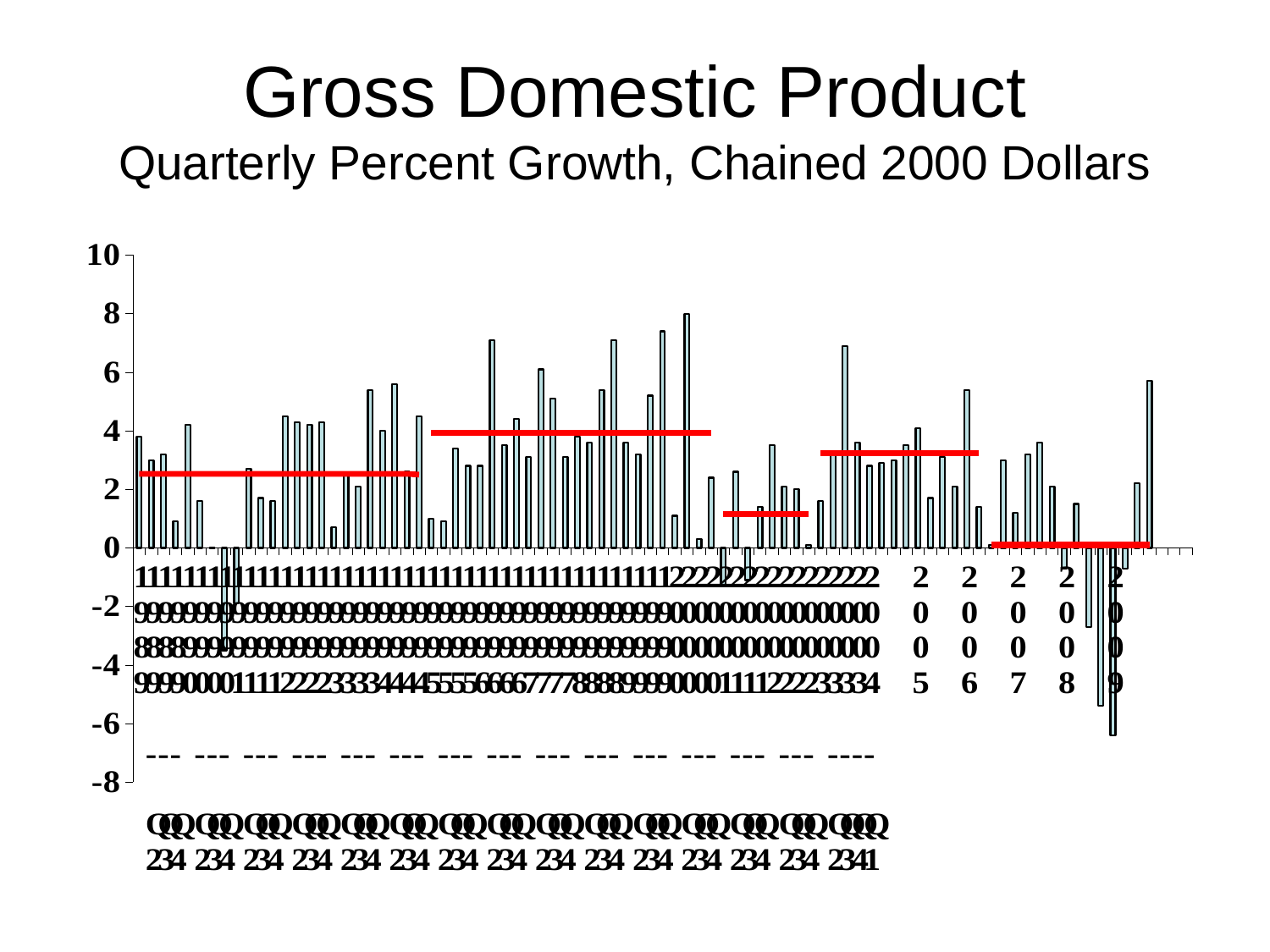
What is the title of the chart? Gross Domestic Product Is the value of the lowest bar greater or less than -8? greater Is the value of the lowest bar greater or less than -4? less How many red horizontal lines are drawn across the bars? 5 Is the value of the tallest bar greater or less than 6? greater What kind of chart is shown on the slide? bar chart